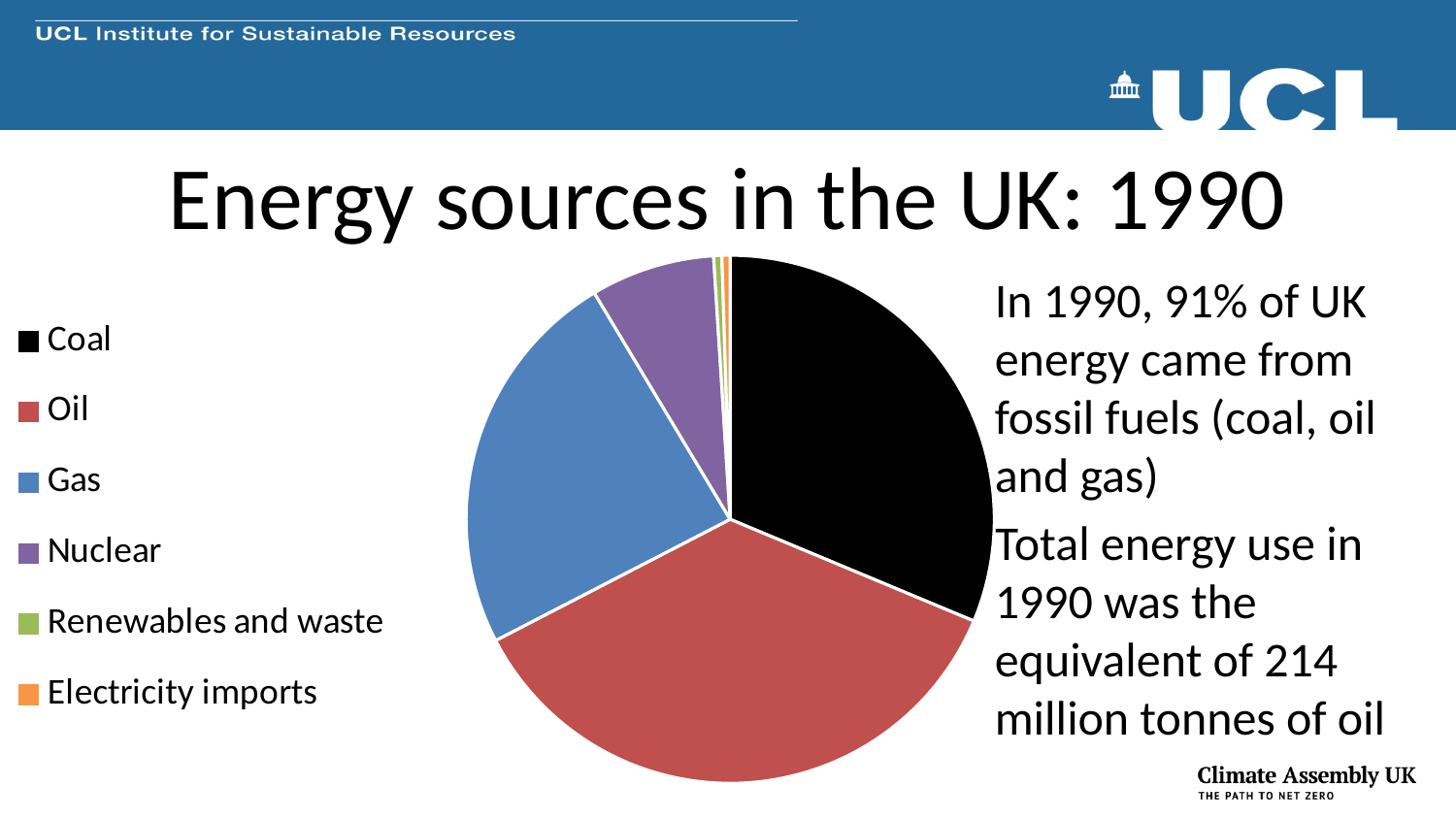
Which slice is larger, Oil or Gas? Oil Which slice is larger, Gas or Nuclear? Gas Which slice is larger, Coal or Nuclear? Coal What kind of chart is shown on the slide? pie chart What is the title of the chart? Energy sources in the UK: 1990 What colour represents Coal in the pie chart? black How many entries does the legend list? 6 How many energy source categories does the pie chart show? 6